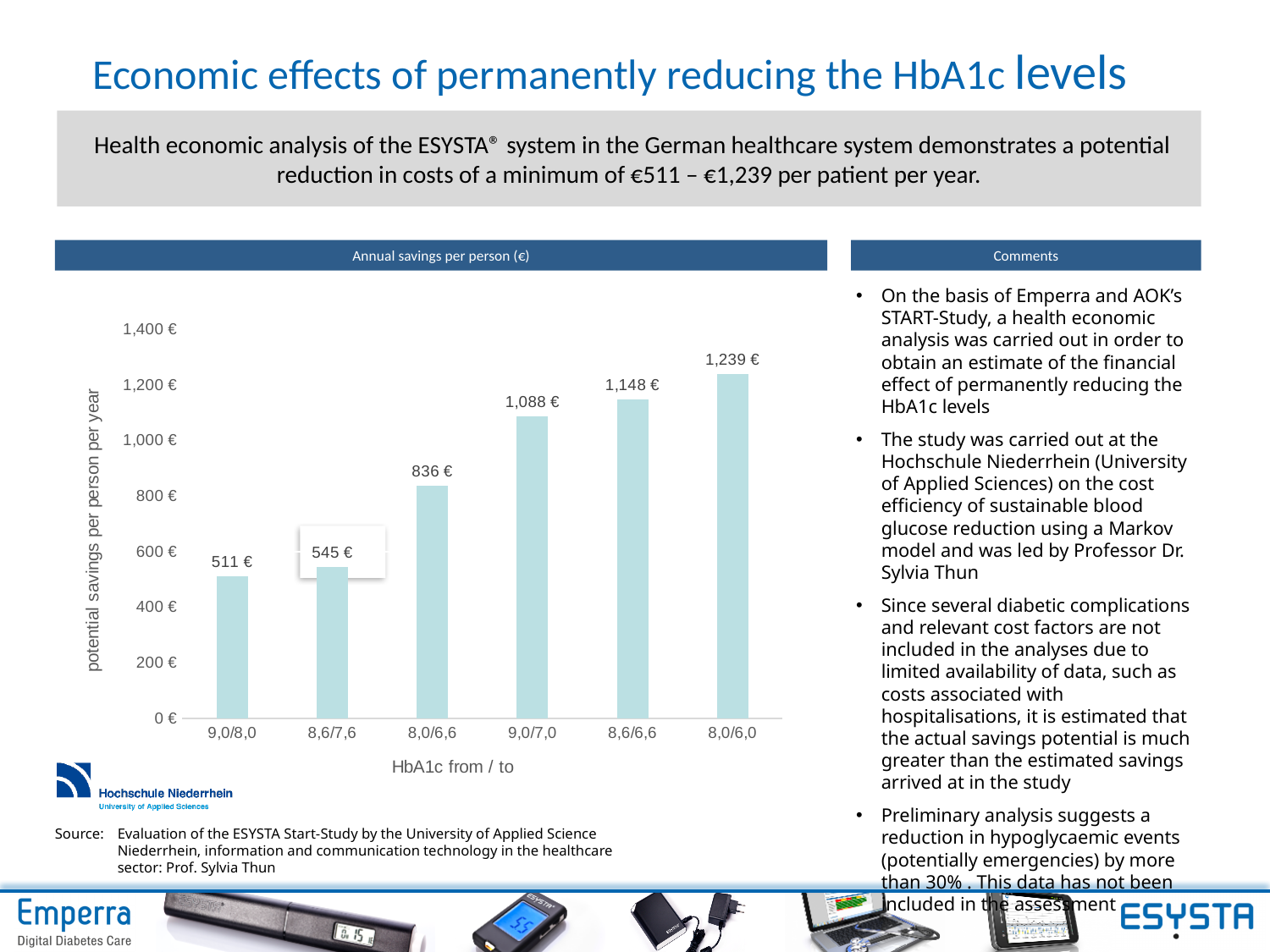
What is the annual savings per person for the HbA1c reduction from 8,0 to 6,6? 836 € What is the annual savings per person for the HbA1c reduction from 8,6 to 6,6? 1,148 € Is the annual savings value for 8,0/6,6 greater or less than 1,000 €? less What is the label of the y axis on the chart? potential savings per person per year Which HbA1c from/to category has the highest annual savings per person? 8,0/6,0 What kind of chart is used to show annual savings per person? bar chart How many HbA1c from/to categories are shown on the chart? 6 Which has higher annual savings per person: 9,0/7,0 or 8,6/7,6? 9,0/7,0 Which HbA1c from/to category has the lowest annual savings per person? 9,0/8,0 What is the difference in annual savings per person between the 8,0/6,0 and 9,0/8,0 categories? 728 € Do the annual savings values rise or fall from left to right along the x axis? rise What is the annual savings per person for the HbA1c reduction from 9,0 to 8,0? 511 €